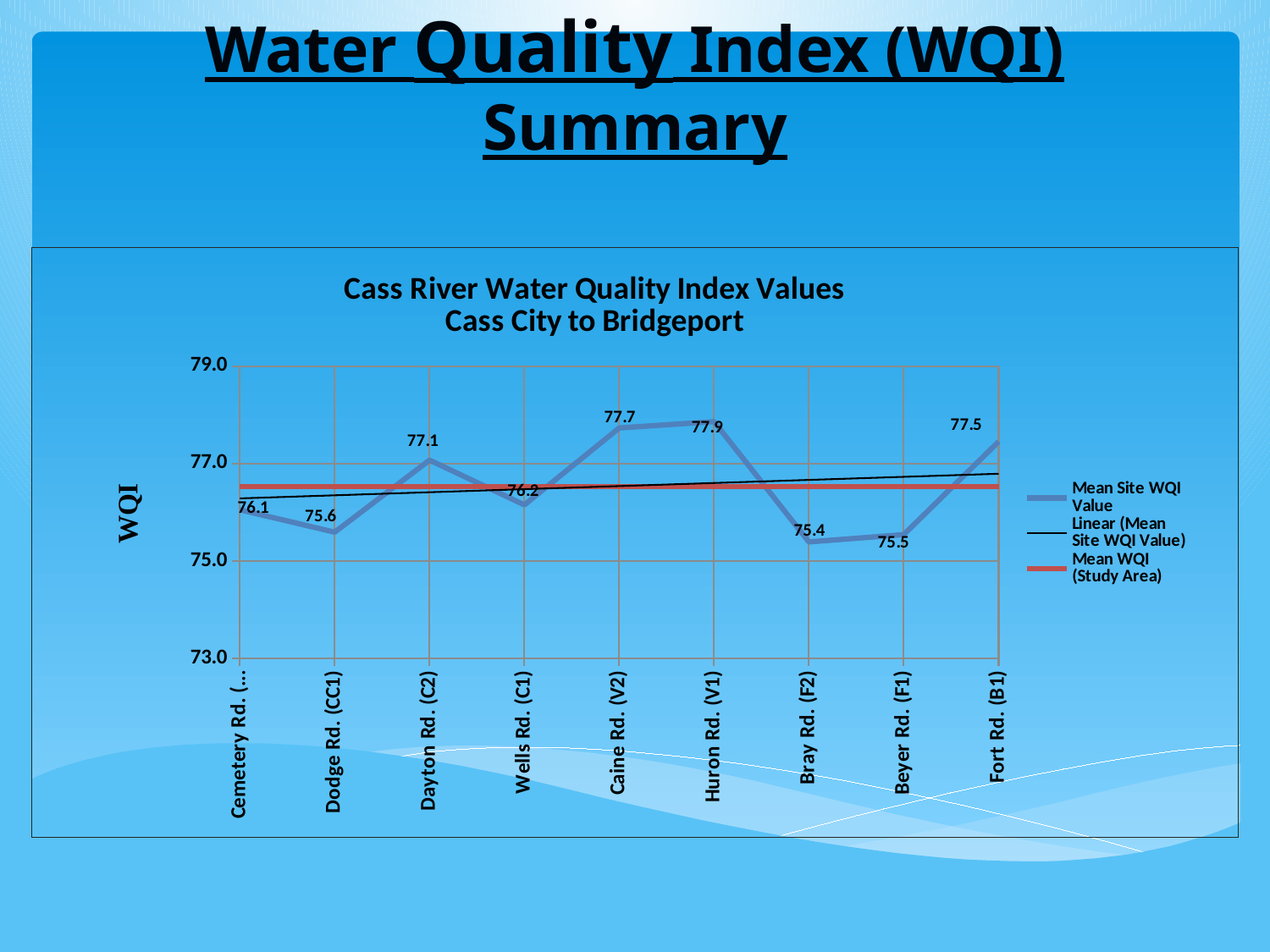
Which site has the lowest Mean Site WQI Value? Bray Rd. (F2) What is the title of the chart? Cass River Water Quality Index Values Cass City to Bridgeport What is the Mean Site WQI Value for Fort Rd. (B1)? 77.5 What is the Mean Site WQI Value for Huron Rd. (V1)? 77.9 What is the difference between the Mean Site WQI Values for Caine Rd. (V2) and Bray Rd. (F2)? 2.3 Which site has the highest Mean Site WQI Value? Huron Rd. (V1) Which has a higher Mean Site WQI Value, Dayton Rd. (C2) or Wells Rd. (C1)? Dayton Rd. (C2) How many sites are plotted along the x axis? 9 What is the Mean Site WQI Value for Dodge Rd. (CC1)? 75.6 How many entries does the legend list? 3 Is the Mean WQI (Study Area) line greater or less than 77.0? less What kind of chart is shown? line chart